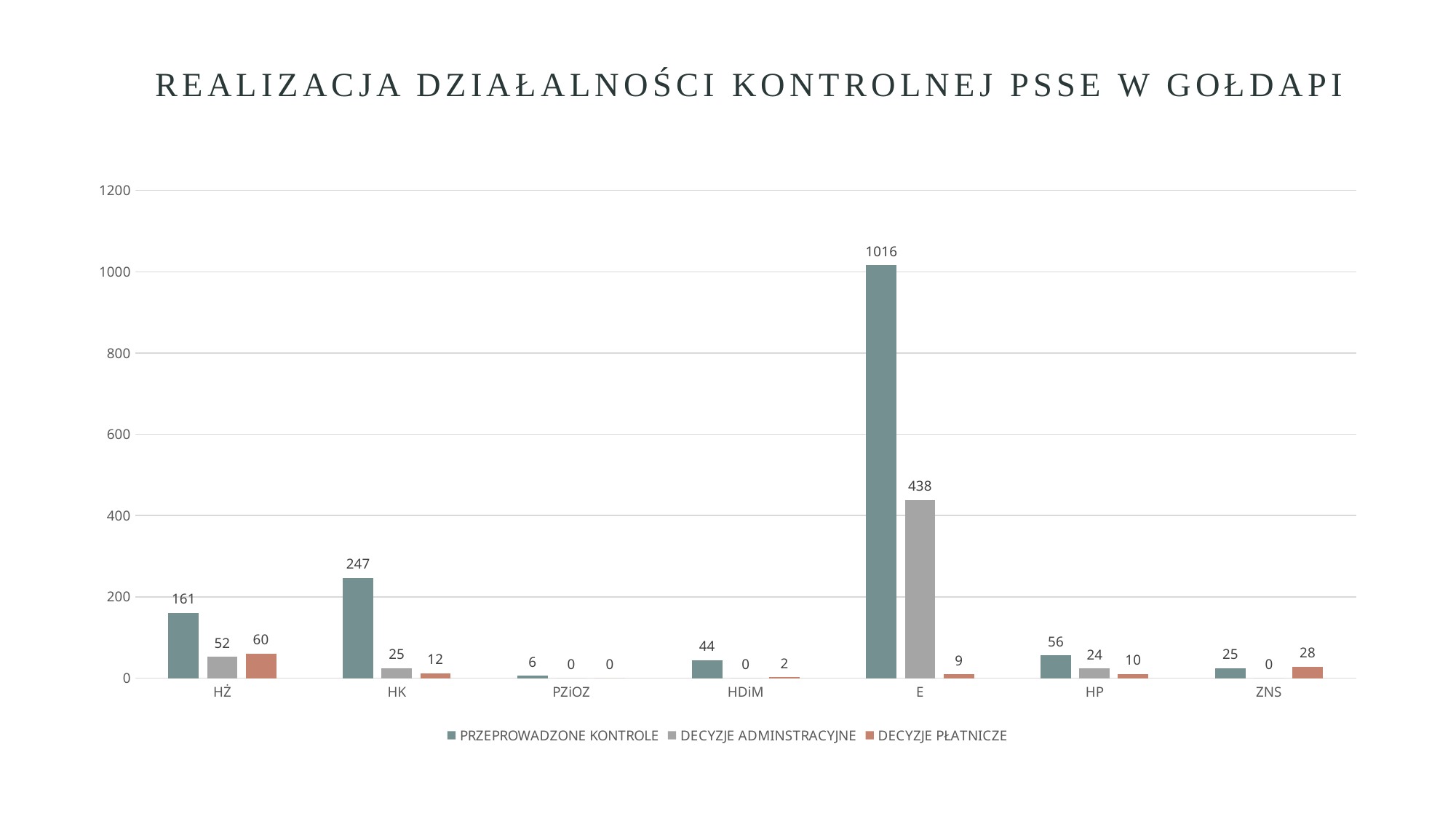
How many categories are shown on the x axis? 7 What kind of chart is shown on the slide? bar chart Which is larger for HŻ: DECYZJE ADMINSTRACYJNE or DECYZJE PŁATNICZE? DECYZJE PŁATNICZE Which category has the highest value for PRZEPROWADZONE KONTROLE? E Which category has the lowest value for PRZEPROWADZONE KONTROLE? PZiOZ What is the title of the chart? REALIZACJA DZIAŁALNOŚCI KONTROLNEJ PSSE W GOŁDAPI Is the value of PRZEPROWADZONE KONTROLE for HK greater or less than 200? greater What is the value of DECYZJE PŁATNICZE for ZNS? 28 What is the value of PRZEPROWADZONE KONTROLE for E? 1016 What is the difference between PRZEPROWADZONE KONTROLE and DECYZJE ADMINSTRACYJNE for E? 578 How many series does the legend list? 3 What is the value of DECYZJE ADMINSTRACYJNE for HK? 25